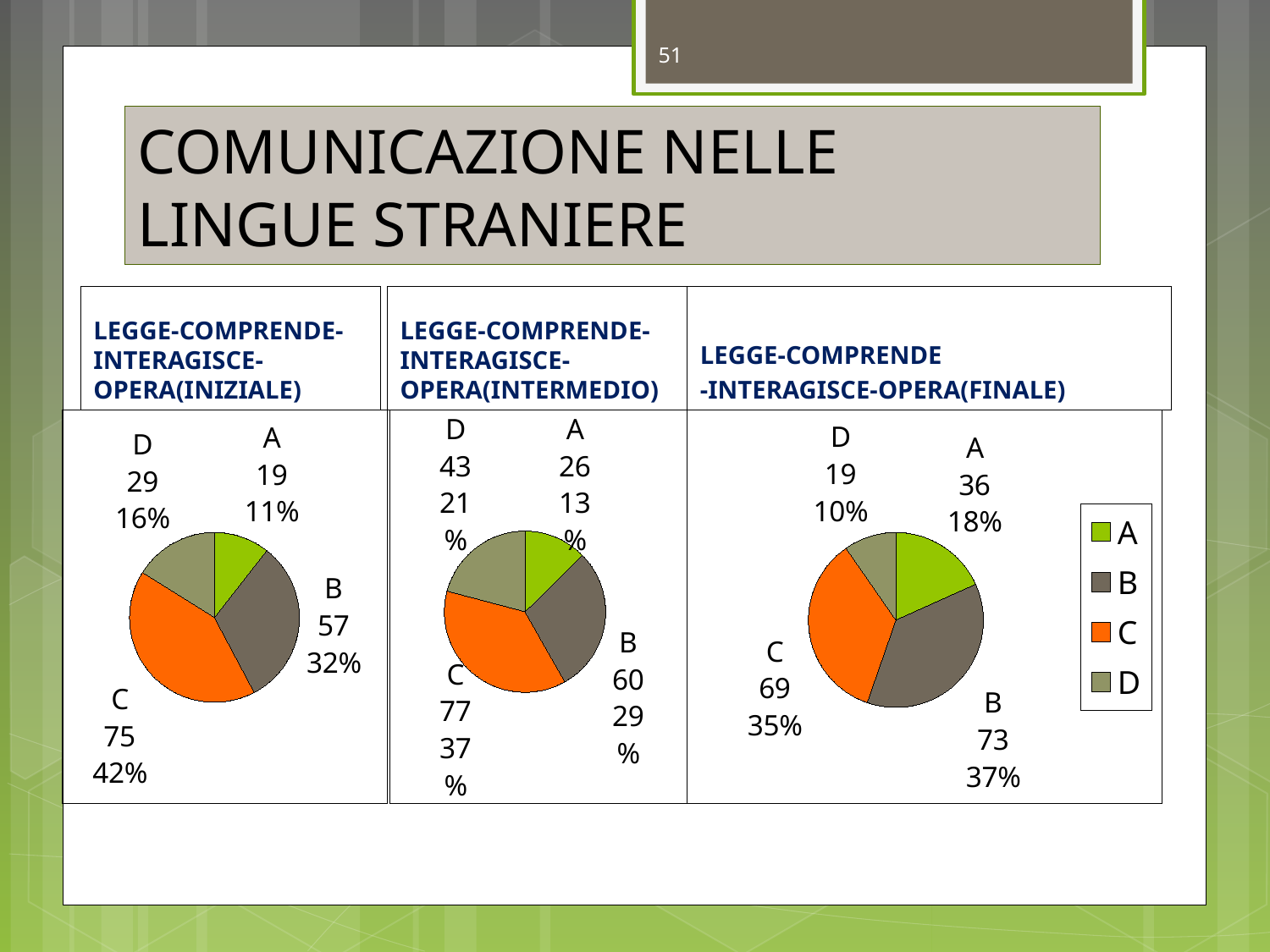
In the LEGGE-COMPRENDE-INTERAGISCE-OPERA(INTERMEDIO) pie chart, which category has the largest value? C In the LEGGE-COMPRENDE-INTERAGISCE-OPERA(FINALE) pie chart, what share of the pie does C represent? 35% In the LEGGE-COMPRENDE-INTERAGISCE-OPERA(INTERMEDIO) pie chart, what is the difference between the values for C and B? 17 In the LEGGE-COMPRENDE-INTERAGISCE-OPERA(INTERMEDIO) pie chart, what is the value for D? 43 What type of chart is used for LEGGE-COMPRENDE-INTERAGISCE-OPERA(INTERMEDIO)? Pie chart In the LEGGE-COMPRENDE-INTERAGISCE-OPERA(FINALE) pie chart, which is larger, the value for B or the value for C? B In the LEGGE-COMPRENDE-INTERAGISCE-OPERA(FINALE) pie chart, which category has the smallest value? D In the LEGGE-COMPRENDE-INTERAGISCE-OPERA(INIZIALE) pie chart, what is the value for C? 75 In the LEGGE-COMPRENDE-INTERAGISCE-OPERA(INIZIALE) pie chart, what share of the pie does B represent? 32% In the LEGGE-COMPRENDE-INTERAGISCE-OPERA(FINALE) pie chart, what is the value for A? 36 How many slices does the LEGGE-COMPRENDE-INTERAGISCE-OPERA(INIZIALE) pie chart have? 4 In the LEGGE-COMPRENDE-INTERAGISCE-OPERA(INIZIALE) pie chart, which category has the smallest value? A